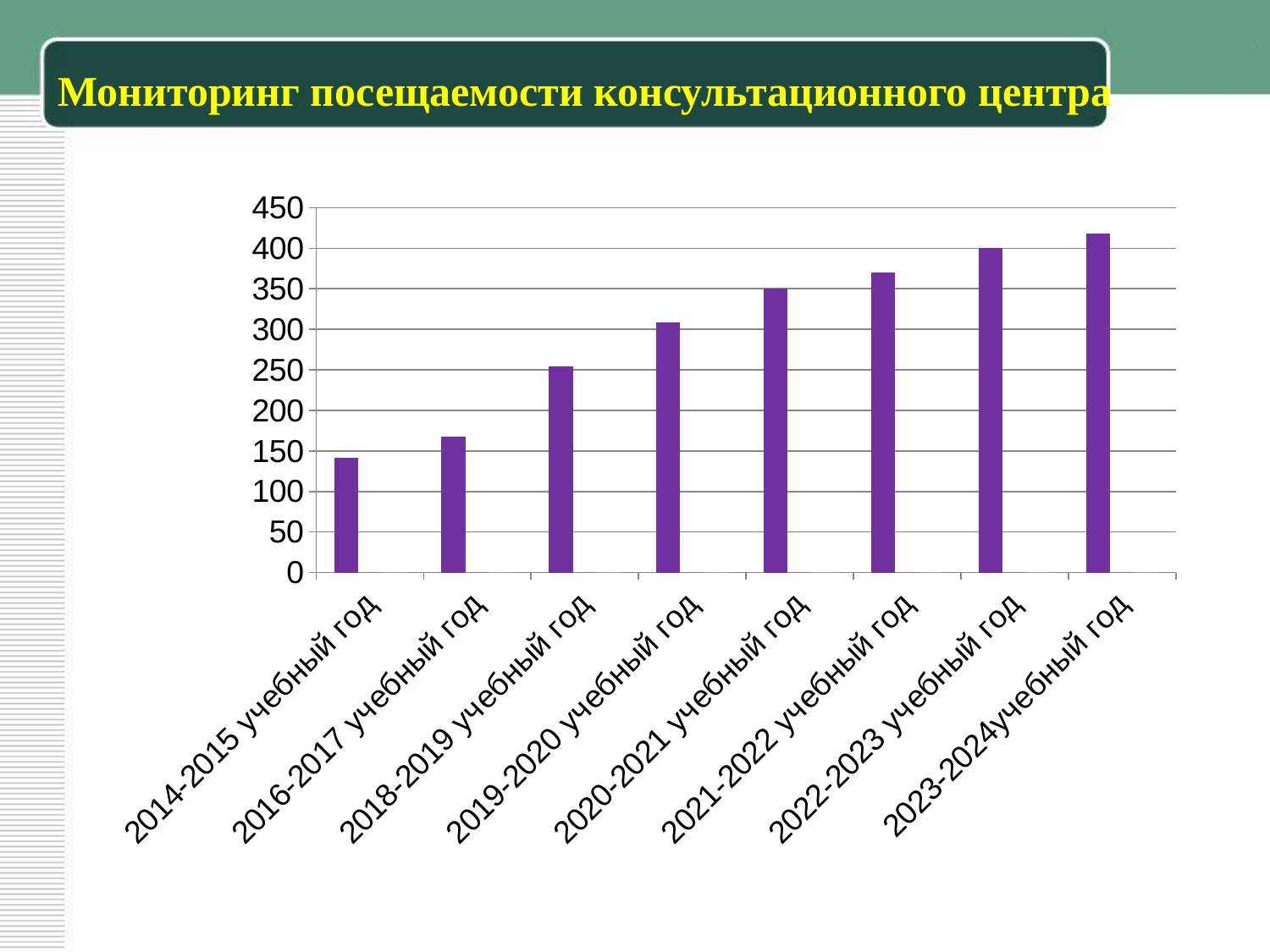
Is the value for 2018-2019 учебный год greater or less than 200? greater Is the value for 2023-2024 учебный год greater or less than 400? greater Which academic year has the lowest value on the chart? 2014-2015 учебный год What kind of chart is shown on the slide? bar chart Is the value for 2016-2017 учебный год greater or less than 150? greater How many academic years (bars) are shown on the chart? 8 Which academic year has the highest value on the chart? 2023-2024 учебный год Do the values rise or fall from left to right along the x axis? rise Which is larger, the value for 2019-2020 учебный год or the value for 2016-2017 учебный год? 2019-2020 учебный год What is the title of the slide containing the chart? Мониторинг посещаемости консультационного центра